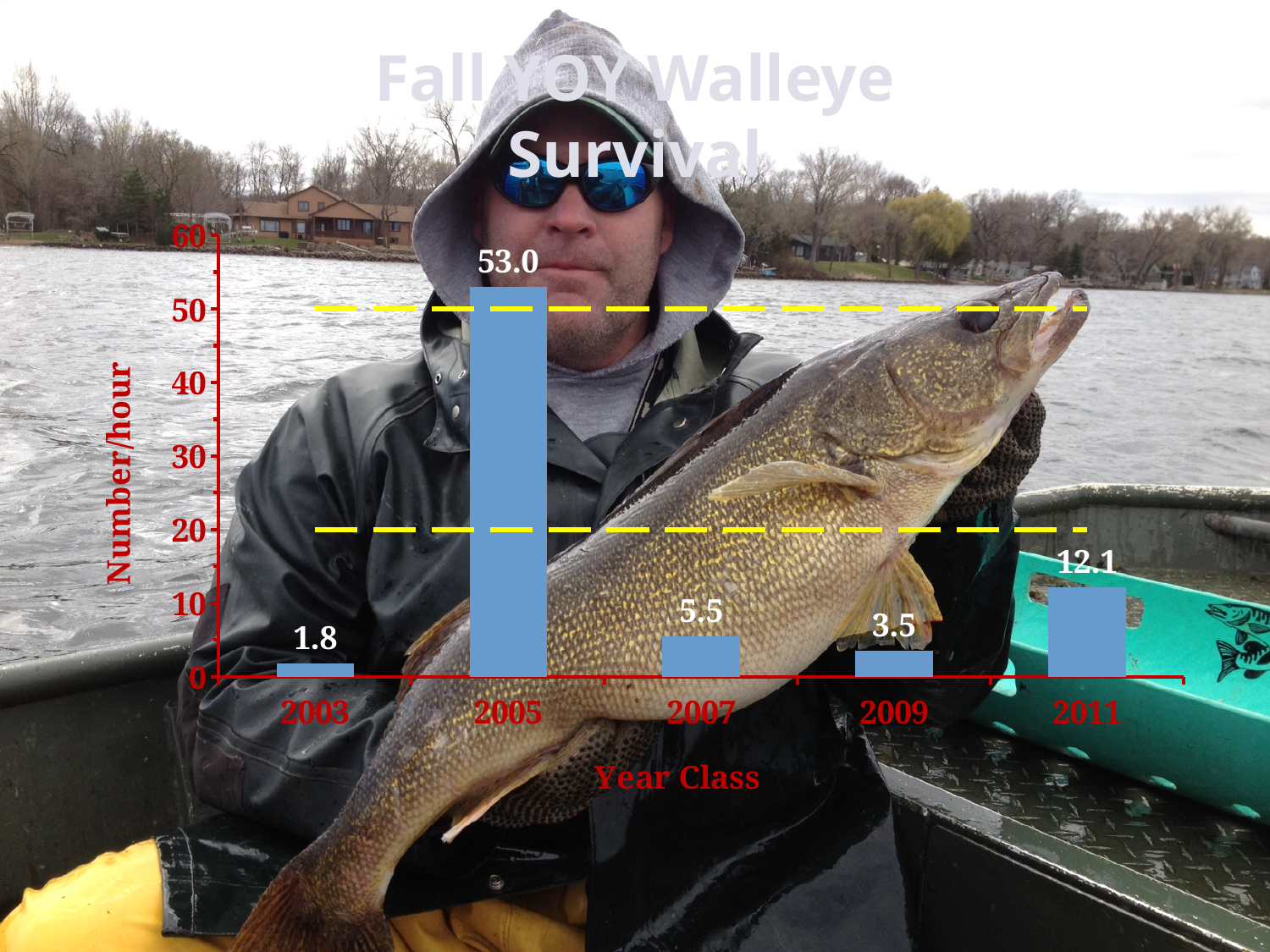
What is the difference between the values for 2007 and 2009? 2.0 What is the difference between the values for 2005 and 2011? 40.9 Which year class has the lowest number per hour? 2003 What kind of chart is shown on the slide? bar chart What is the value for the 2011 year class? 12.1 What is the value for the 2005 year class? 53.0 Which year class has the highest number per hour? 2005 Which is larger, the value for 2007 or the value for 2009? 2007 What is the title of the chart? Fall YOY Walleye Survival What is the value for the 2003 year class? 1.8 Is the value for 2005 greater or less than 50? greater How many year classes are shown on the chart? 5